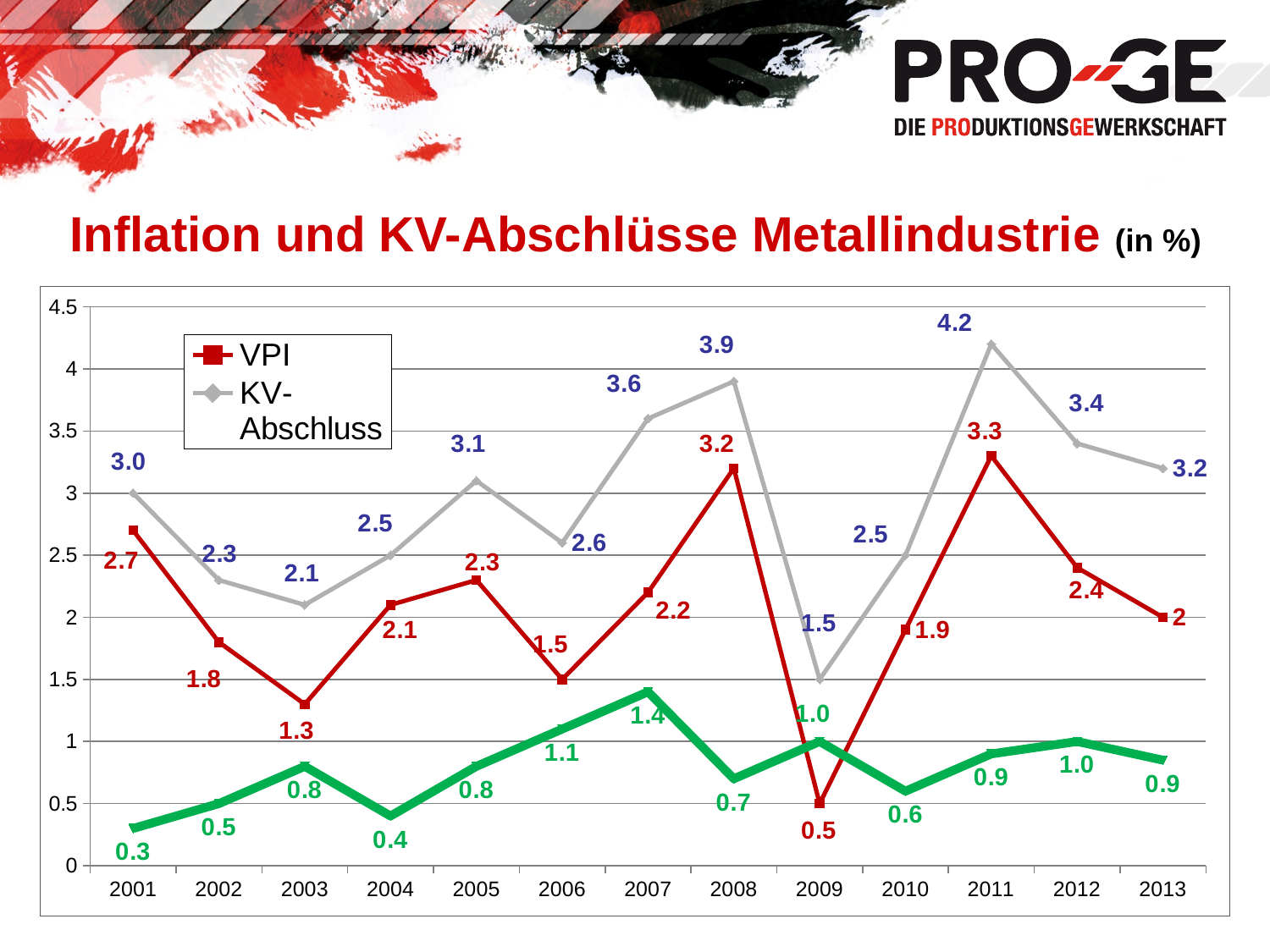
Does the VPI value rise or fall from 2009 to 2011? rise What is the title of the chart? Inflation und KV-Abschlüsse Metallindustrie (in %) Which is larger in 2013, the VPI value or the KV-Abschluss value? KV-Abschluss In which year is the VPI value lowest? 2009 What type of chart is shown on the slide? line chart In which year is the KV-Abschluss value highest? 2011 What is the difference between the KV-Abschluss value and the VPI value in 2007? 1.4 How many years are shown on the x axis? 13 What is the KV-Abschluss value for 2011? 4.2 What is the VPI value for 2008? 3.2 What is the VPI value for 2009? 0.5 How many series does the legend list? 2